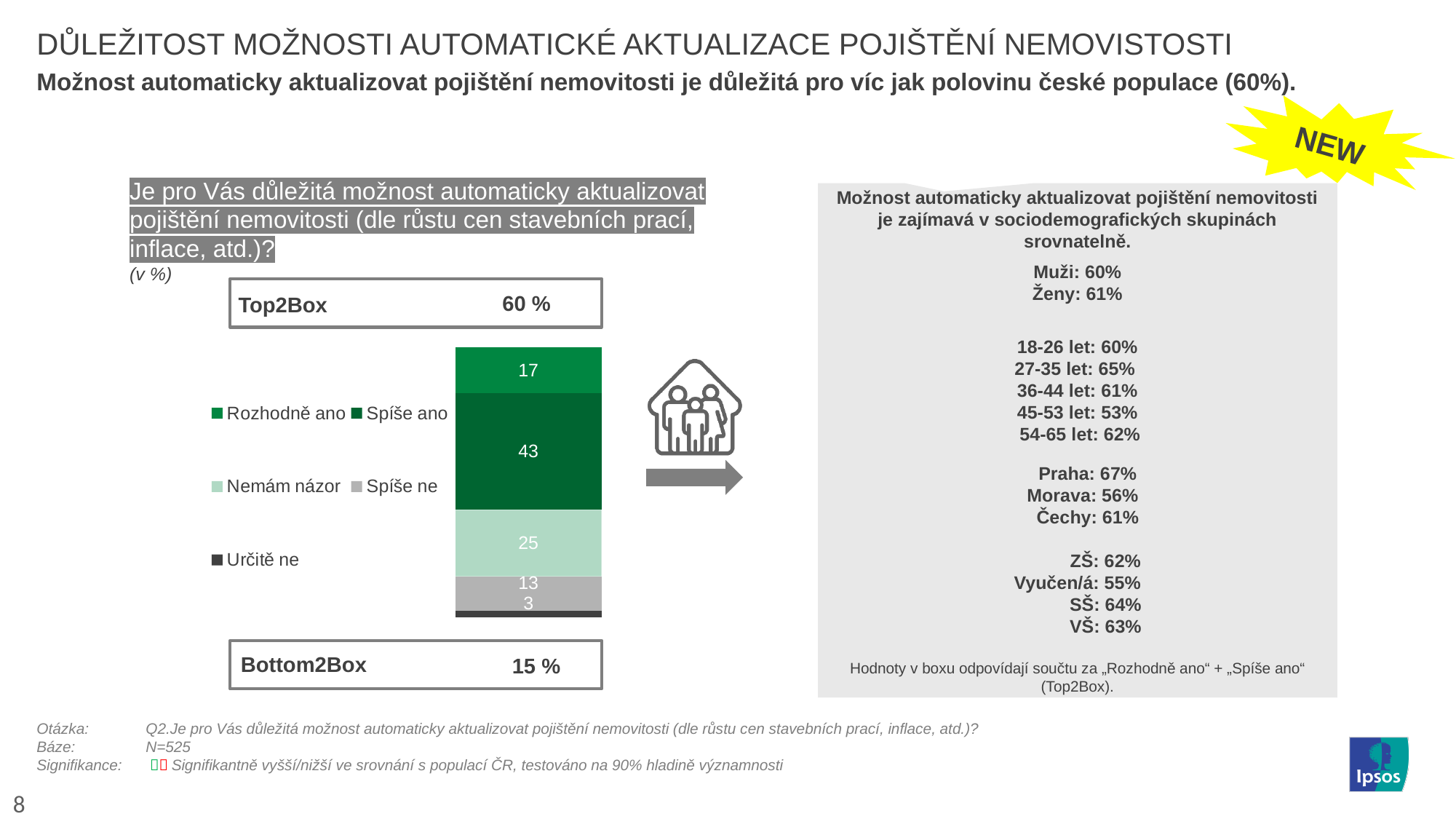
What is the difference between the values for "Spíše ano" and "Rozhodně ano"? 26 Which response category has the smallest segment in the stacked bar? Určitě ne What Top2Box value is shown above the stacked bar? 60 % What is the value for "Spíše ano" in the stacked bar? 43 What is the value for "Nemám názor" in the stacked bar? 25 What kind of chart is shown on the slide? stacked bar chart Which is larger, the value for "Nemám názor" or the value for "Spíše ne"? Nemám názor What is the value for "Spíše ne" in the stacked bar? 13 What is the value for "Určitě ne" in the stacked bar? 3 What is the value for "Rozhodně ano" in the stacked bar? 17 Which response category has the largest segment in the stacked bar? Spíše ano How many response categories does the legend of the chart list? 5